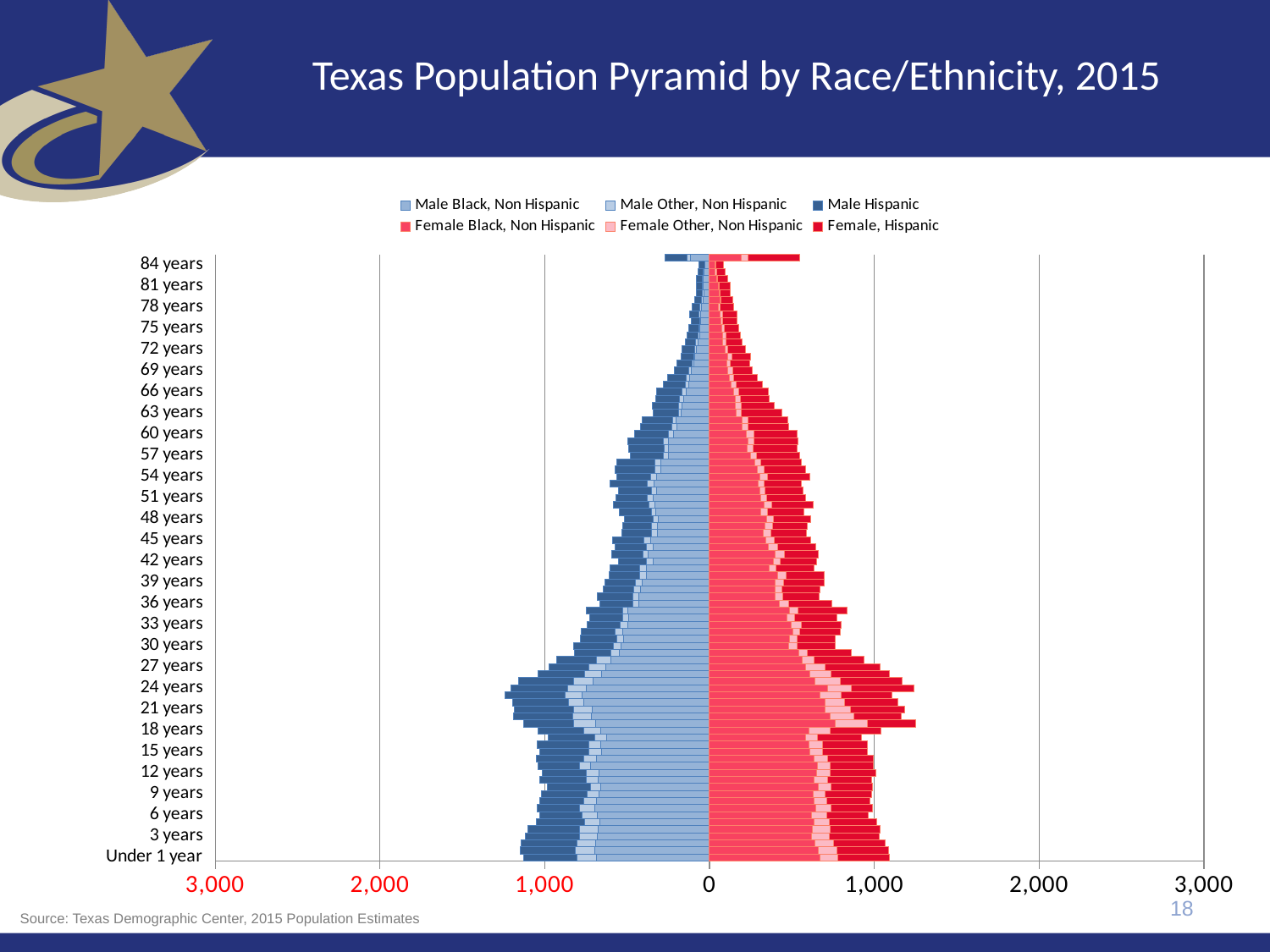
Is the total male value for 24 years greater or less than 1,000? greater Which legend entry is shown in the darkest blue? Male Hispanic Which total male bar is longer, 24 years or 60 years? 24 years Is the total female value for 18 years greater or less than 1,000? greater Is the total male value for 72 years greater or less than 1,000? less What is the title of the chart? Texas Population Pyramid by Race/Ethnicity, 2015 At 84 years, which total bar is longer, the male bar or the female bar? female Moving from 84 years down to Under 1 year, do the total bar lengths generally increase or decrease? increase How many series does the legend list? 6 What kind of chart is shown on the slide? bar chart